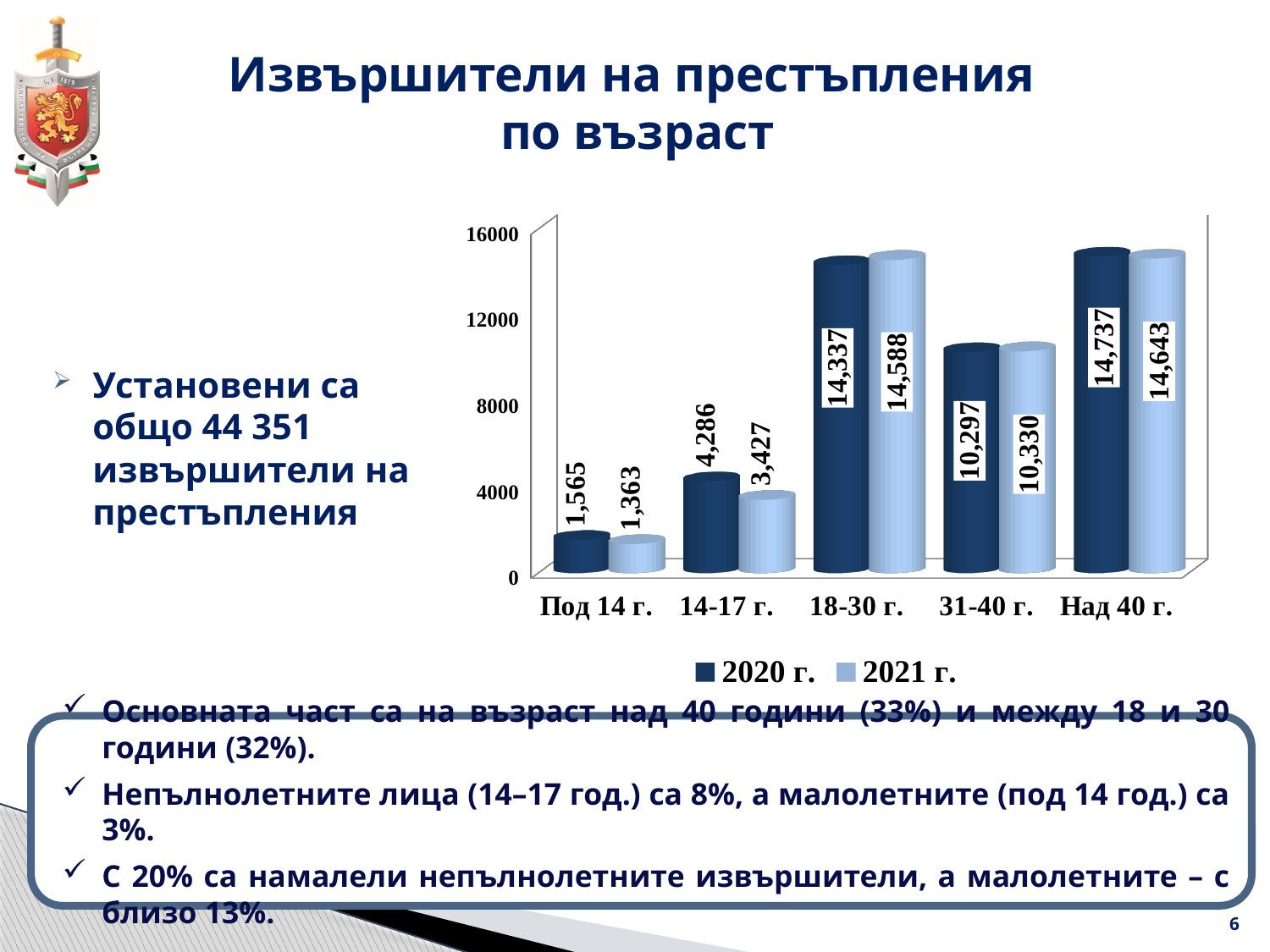
Which age group has the highest value in the 2020 г. series? Над 40 г. Which age group has the lowest value in the 2021 г. series? Под 14 г. What is the value for the 14-17 г. age group in the 2021 г. series? 3,427 What are the two series named in the chart legend? 2020 г. and 2021 г. Is the value for the 31-40 г. age group in 2021 г. greater or less than 12000? less What is the value for the 18-30 г. age group in the 2020 г. series? 14,337 What kind of chart is shown on the slide? bar chart What is the value for the Под 14 г. age group in the 2020 г. series? 1,565 For the 18-30 г. age group, which series has the larger value, 2020 г. or 2021 г.? 2021 г. What is the difference between the 2020 г. and 2021 г. values for the 14-17 г. age group? 859 How many series does the chart legend list? 2 How many age groups are shown on the x axis of the chart? 5